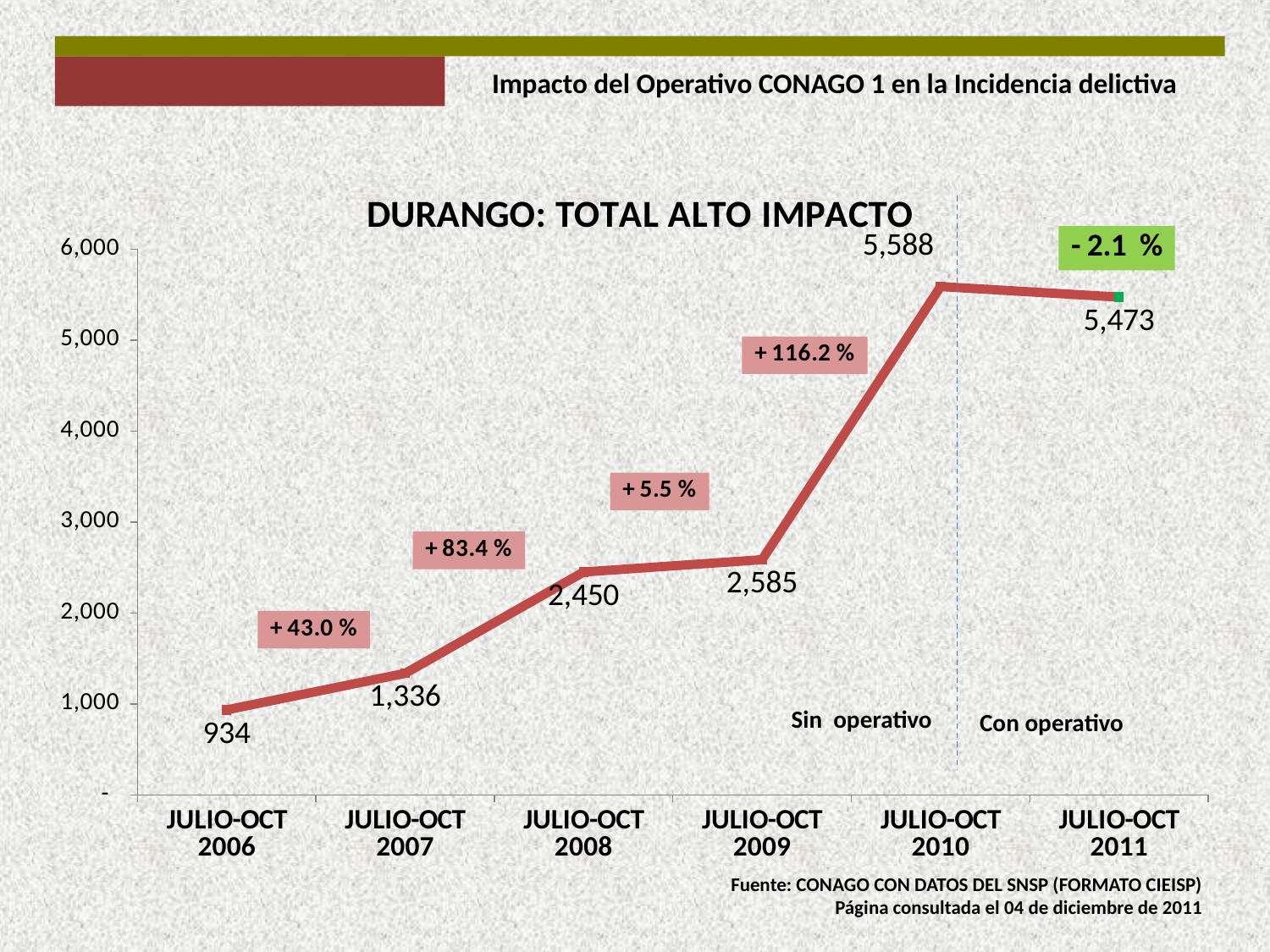
What percentage change is shown between JULIO-OCT 2009 and JULIO-OCT 2010? + 116.2 % What is the value for JULIO-OCT 2006? 934 What is the difference between the values for JULIO-OCT 2009 and JULIO-OCT 2008? 135 What is the difference between the values for JULIO-OCT 2010 and JULIO-OCT 2011? 115 Which period has the lowest value? JULIO-OCT 2006 Which is larger, the value for JULIO-OCT 2007 or JULIO-OCT 2008? JULIO-OCT 2008 What is the value for JULIO-OCT 2011? 5,473 What is the value for JULIO-OCT 2010? 5,588 What kind of chart is shown? line chart How many periods are plotted on the chart? 6 Which period has the highest value? JULIO-OCT 2010 Is the value for JULIO-OCT 2009 greater or less than 3,000? less